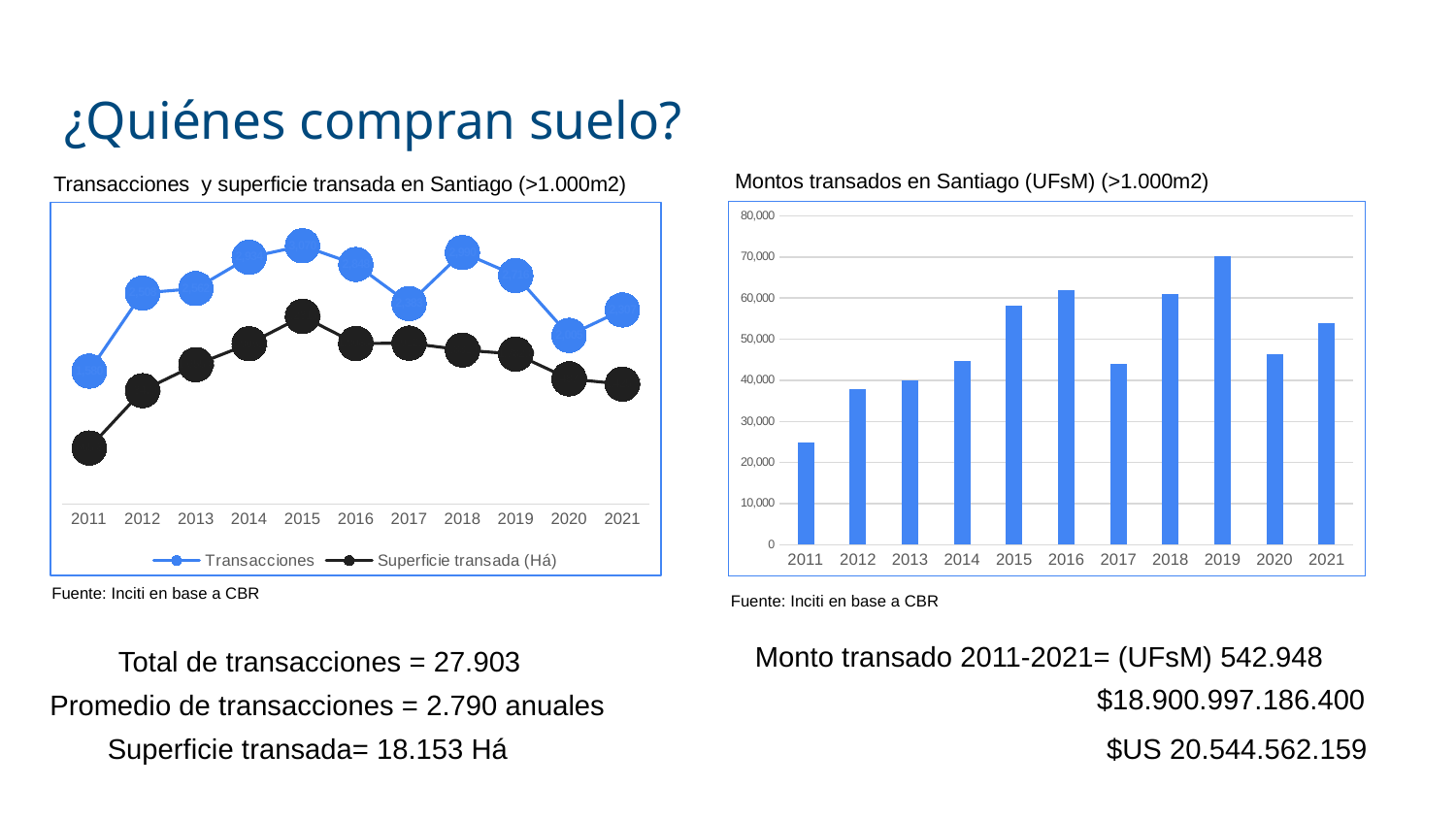
In the chart 'Montos transados en Santiago (UFsM) (>1.000m2)', which year has the lowest value? 2011 In the chart 'Transacciones y superficie transada en Santiago (>1.000m2)', does the 'Superficie transada (Há)' series rise or fall from 2011 to 2015? rise In the chart 'Montos transados en Santiago (UFsM) (>1.000m2)', is the value for 2019 greater or less than 60,000? greater In the chart 'Montos transados en Santiago (UFsM) (>1.000m2)', is the value for 2011 greater or less than 30,000? less What kind of chart is the chart titled 'Montos transados en Santiago (UFsM) (>1.000m2)'? bar chart In the chart 'Montos transados en Santiago (UFsM) (>1.000m2)', which year has the highest value? 2019 How many series does the legend of the chart 'Transacciones y superficie transada en Santiago (>1.000m2)' list? 2 In the chart 'Montos transados en Santiago (UFsM) (>1.000m2)', is the value for 2020 greater or less than 50,000? less In the chart 'Transacciones y superficie transada en Santiago (>1.000m2)', which year has the lowest value for 'Superficie transada (Há)'? 2011 What kind of chart is the chart titled 'Transacciones y superficie transada en Santiago (>1.000m2)'? line chart In the chart 'Montos transados en Santiago (UFsM) (>1.000m2)', which is larger, the value for 2017 or the value for 2019? 2019 How many years are shown on the x axis of the chart 'Montos transados en Santiago (UFsM) (>1.000m2)'? 11